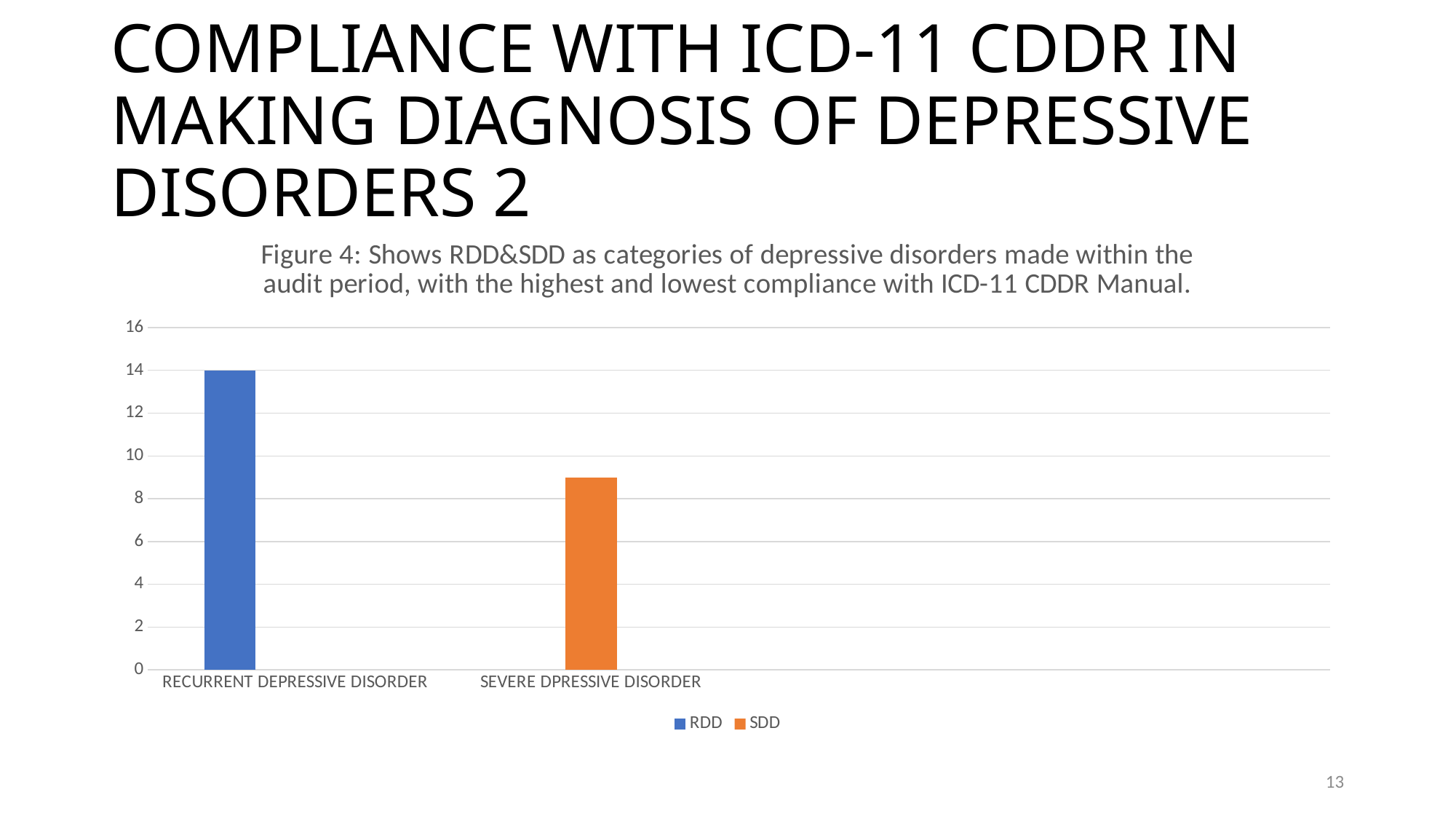
What is the value for Recurrent Depressive Disorder? 14 Is the value for Severe Depressive Disorder greater or less than 8? greater Which is larger, the value for Recurrent Depressive Disorder or the value for Severe Depressive Disorder? Recurrent Depressive Disorder Is the value for Severe Depressive Disorder greater or less than 10? less Is the value for Recurrent Depressive Disorder greater or less than 12? greater How many categories are shown on the x axis? 2 Which category has the lowest value? Severe Depressive Disorder Which category has the highest value? Recurrent Depressive Disorder How many series does the legend list? 2 Do the values rise or fall from left to right along the x axis? fall What kind of chart is shown on the slide? bar chart What colour is the bar for SDD? orange